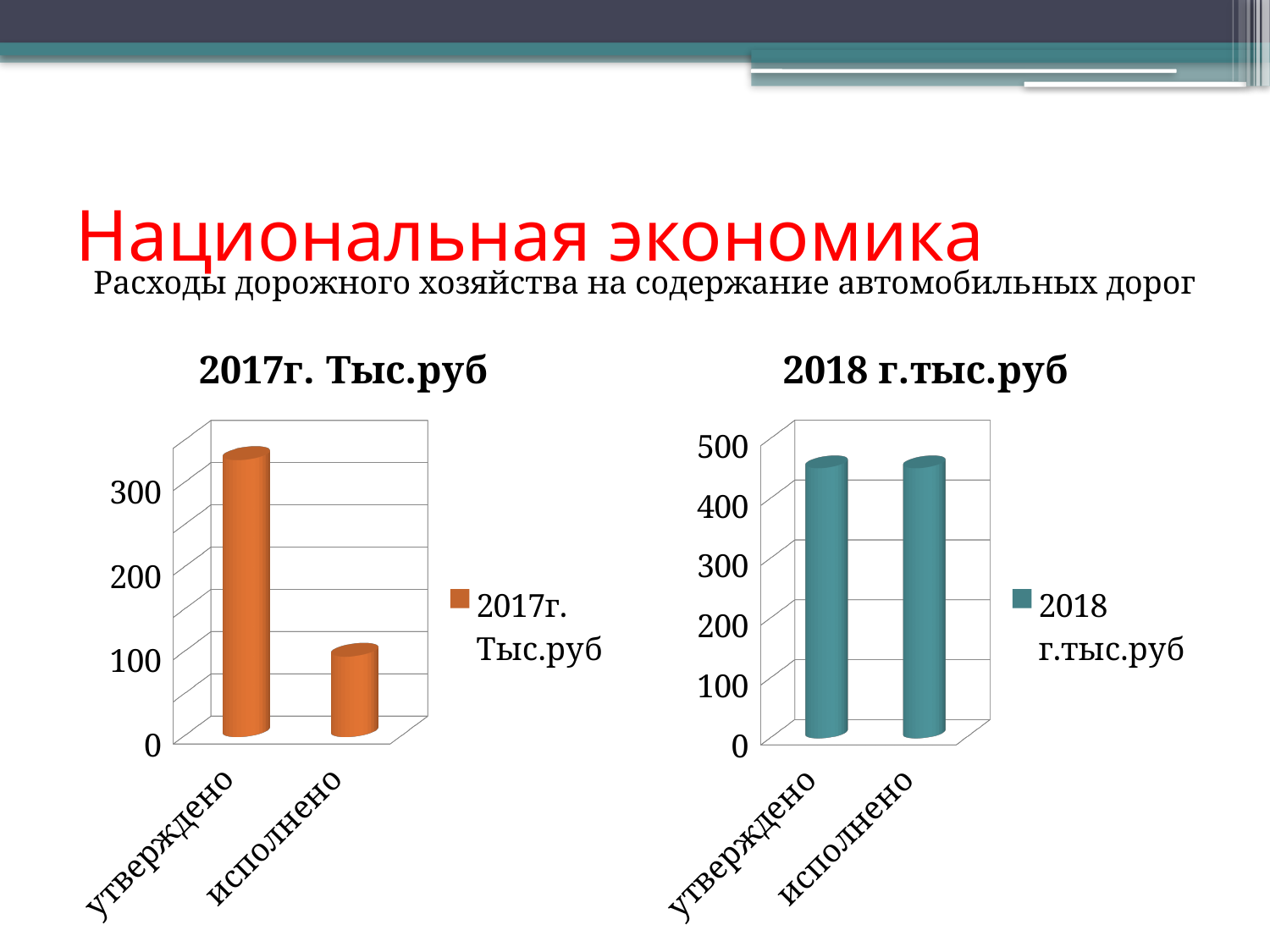
In the chart titled "2017г. Тыс.руб", is the value for исполнено greater or less than 200? less What is the legend entry of the chart titled "2018 г.тыс.руб"? 2018 г.тыс.руб In the chart titled "2017г. Тыс.руб", which category has the lowest value? исполнено In the chart titled "2017г. Тыс.руб", is the value for утверждено greater or less than 300? greater In the chart titled "2017г. Тыс.руб", which is larger: утверждено or исполнено? утверждено How many series does the legend of the chart titled "2017г. Тыс.руб" list? 1 In the chart titled "2018 г.тыс.руб", is the value for исполнено greater or less than 500? less How many categories are shown in the chart titled "2018 г.тыс.руб"? 2 What kind of chart is the chart titled "2018 г.тыс.руб"? bar chart In the chart titled "2017г. Тыс.руб", which category has the highest value? утверждено What kind of chart is the chart titled "2017г. Тыс.руб"? bar chart